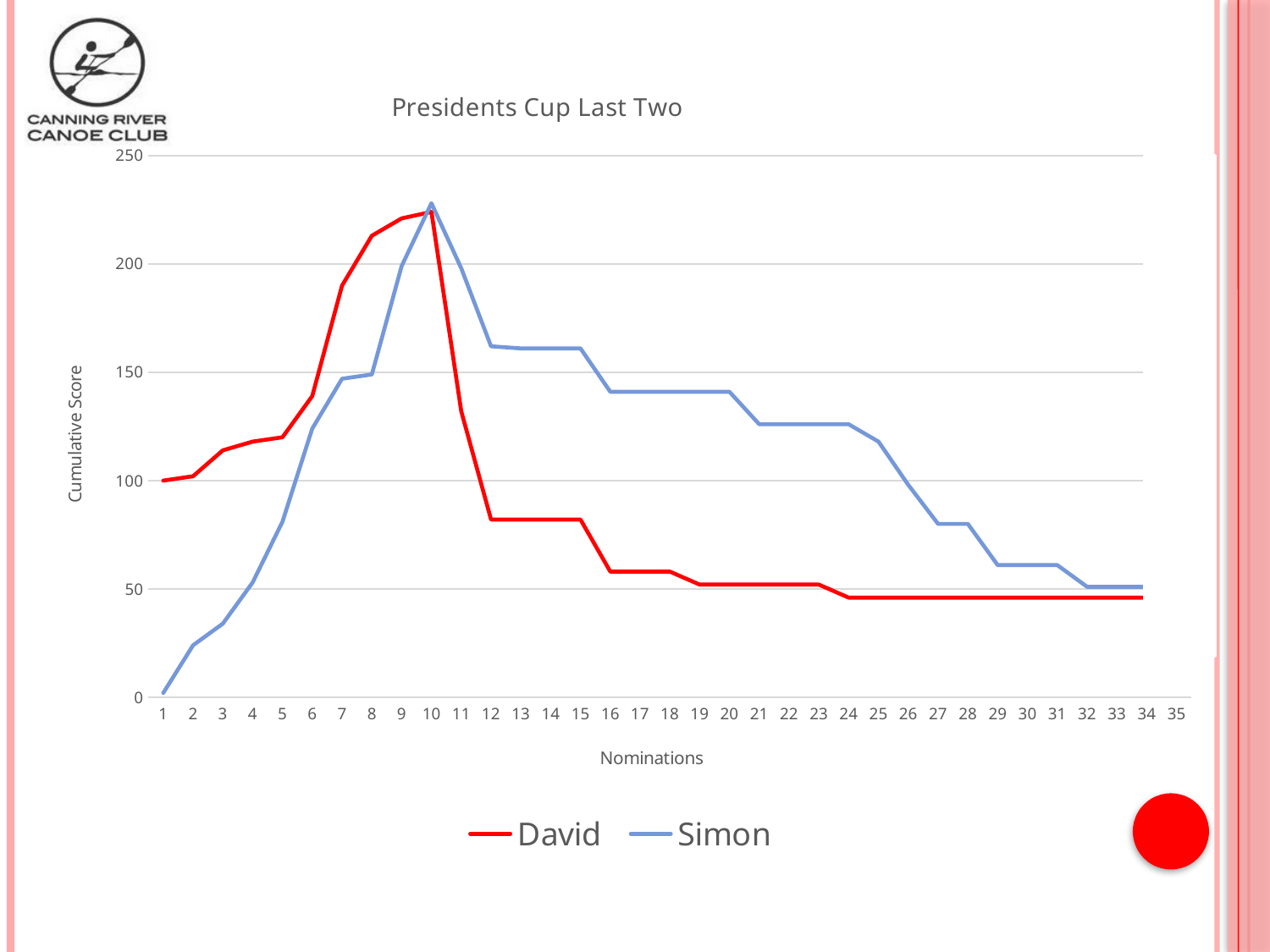
Is Simon's value at nomination 27 greater or less than 100? less What is the title of the chart? Presidents Cup Last Two At nomination 20, which series has the higher cumulative score, David or Simon? Simon How many series does the legend list? 2 Is Simon's value at nomination 16 greater or less than 150? less Is David's value at nomination 8 greater or less than 200? greater What is the label of the y axis? Cumulative Score At nomination 5, which series has the higher cumulative score, David or Simon? David Does David's cumulative score rise or fall from nomination 10 to nomination 34? fall What kind of chart is shown on the slide? line chart What is David's cumulative score at nomination 1? 100